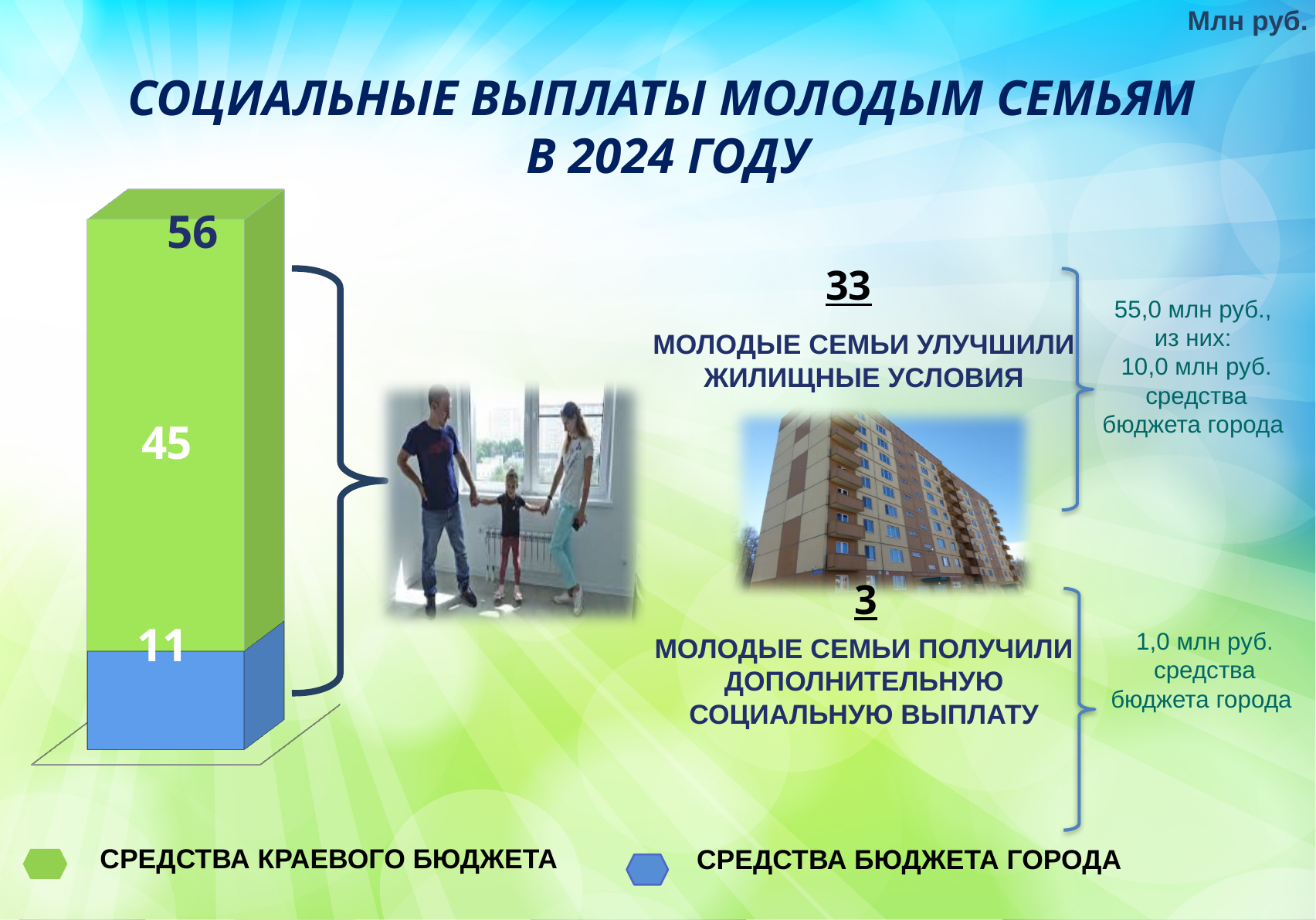
What is the total of the stacked bar? 56 How many series does the legend list? 2 What colour represents средства бюджета города in the legend? blue What type of chart is shown on the slide? bar chart Which segment of the stacked bar is larger: средства краевого бюджета or средства бюджета города? средства краевого бюджета What is the value of the blue segment (средства бюджета города) in the stacked bar? 11 What unit is indicated for the chart values in the top right corner of the slide? Млн руб. Which series is the largest segment in the stacked bar? средства краевого бюджета How many bars are plotted in the chart? 1 What is the difference between the краевой бюджет segment and the бюджет города segment? 34 What is the value of the green segment (средства краевого бюджета) in the stacked bar? 45 Which series is the smallest segment in the stacked bar? средства бюджета города